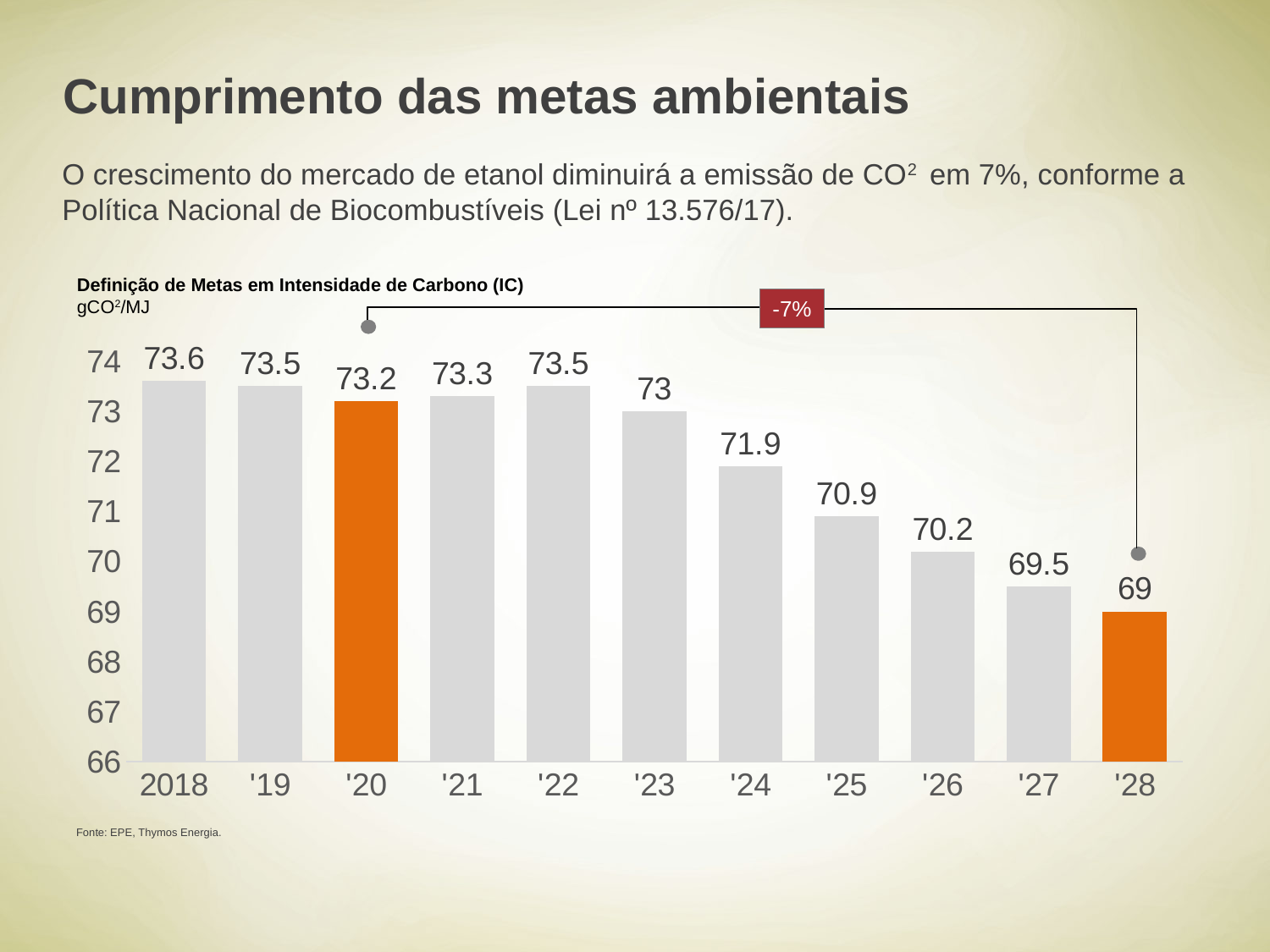
Which year has the highest value? 2018 What is the difference between the values for '20 and '28? 4.2 How many years are shown on the x axis? 11 What is the value shown for '28? 69 What percentage change is shown in the red label above the chart? -7% Is the value for '26 greater or less than 71? less What is the value shown for '24? 71.9 Do the values generally rise or fall from '22 to '28? fall Which is larger, the value for '21 or the value for '23? '21 Which year has the lowest value? '28 What is the carbon intensity value for 2018? 73.6 What kind of chart is shown? bar chart